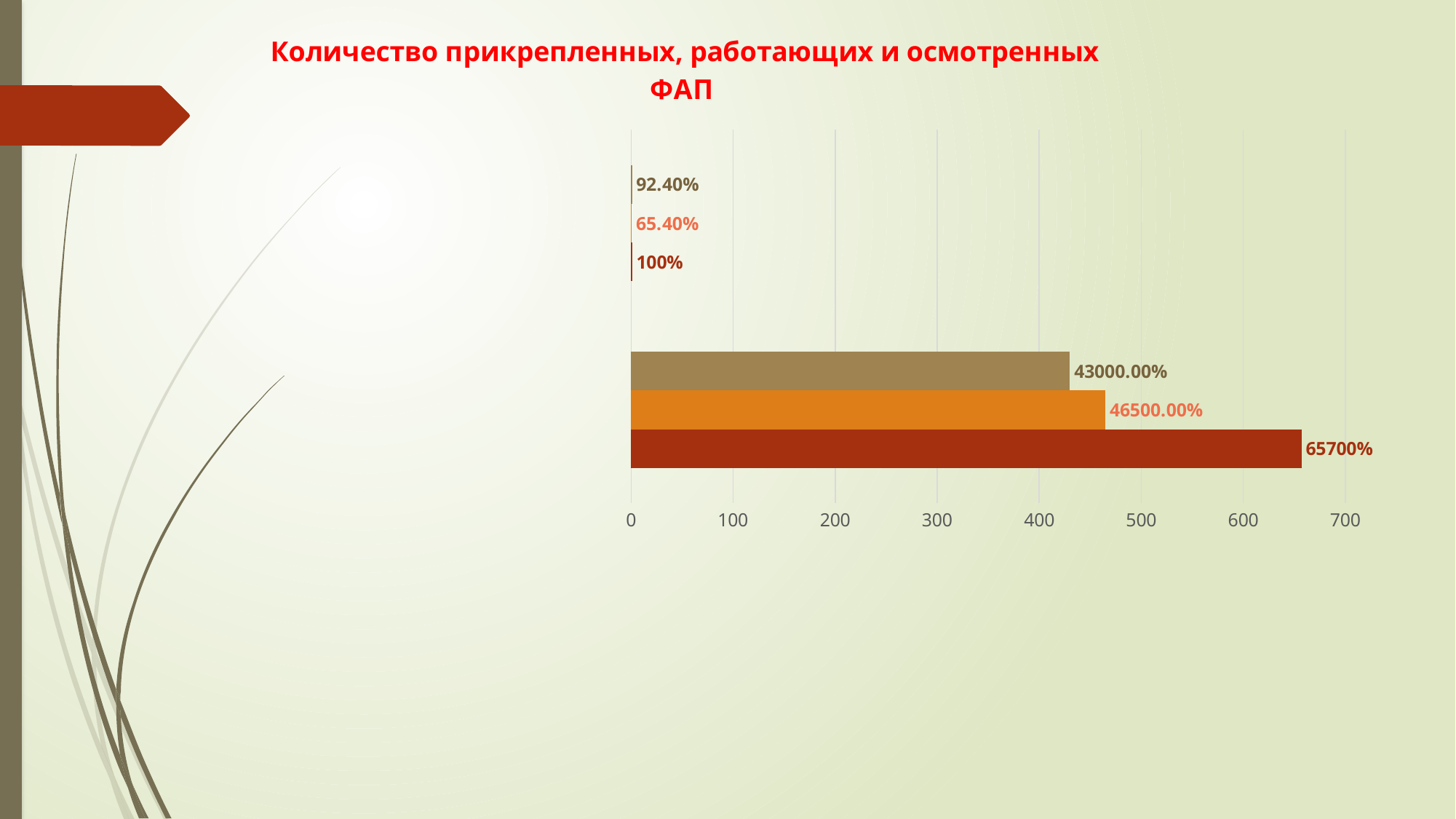
What is the topmost data label in the upper group of the chart? 92.40% Is the dark red bar in the lower group greater or less than 600 on the axis? greater What value is labelled on the orange bar in the lower group of bars? 46500.00% What is the difference between the orange bar's label (46500.00%) and the brown bar's label (43000.00%) in the lower group? 3500.00% What value is labelled on the brown bar in the lower group of bars? 43000.00% Which bar in the lower group is the longest? the dark red bar (65700%) What kind of chart is shown on the slide? bar chart Which bar in the lower group is the shortest? the brown bar (43000.00%) What is the middle (orange) data label in the upper group of the chart? 65.40% What is the title of the chart? Количество прикрепленных, работающих и осмотренных ФАП In the lower group, which is larger: the orange bar or the brown bar? the orange bar What value is labelled on the dark red bar in the lower group of bars? 65700%